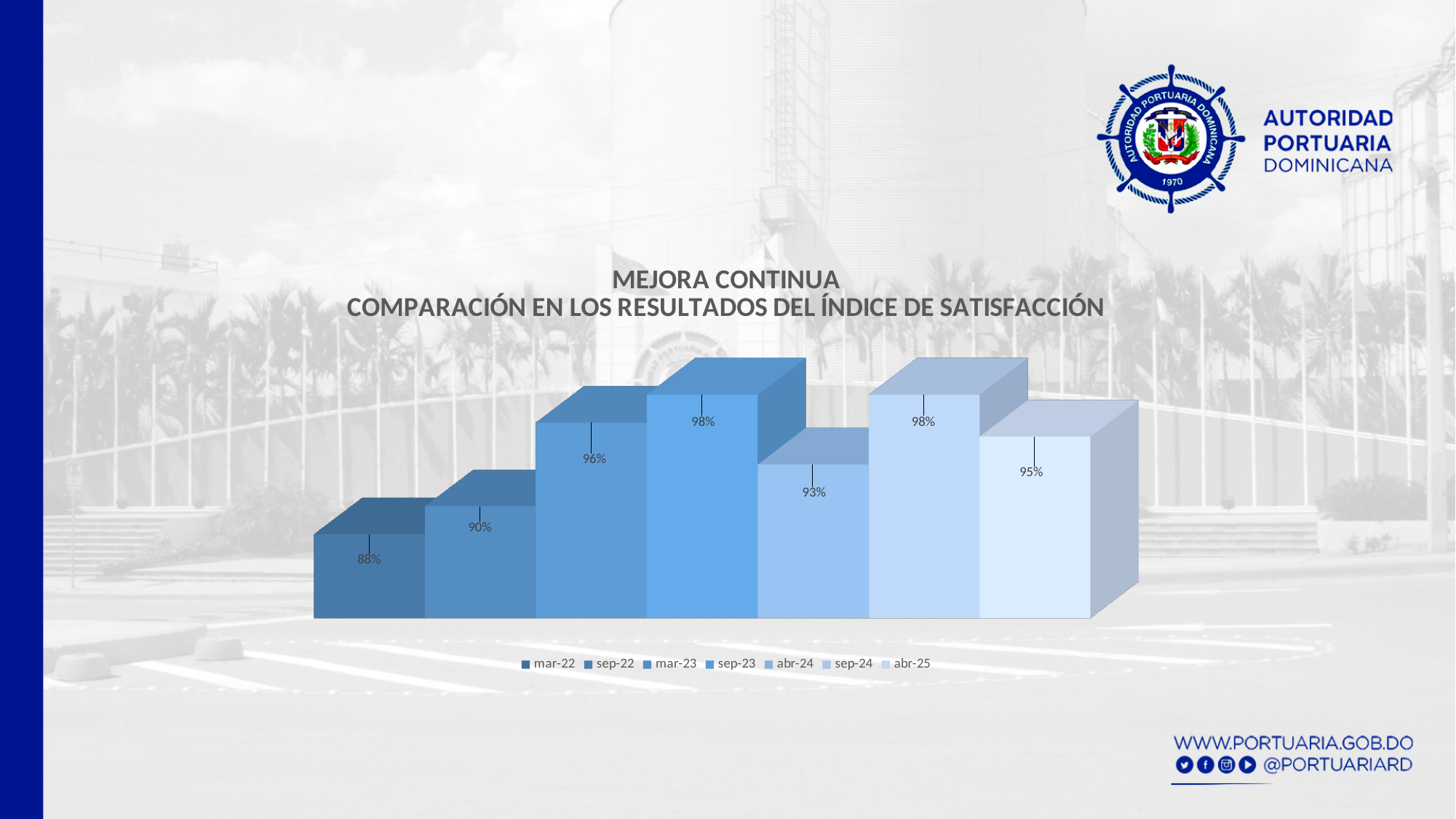
What kind of chart is shown on the slide? Bar chart What is the satisfaction index value for sep-22? 90% How many bars are plotted in the chart? 7 What is the satisfaction index value for mar-22? 88% How many entries does the legend list? 7 What is the satisfaction index value for mar-23? 96% What is the satisfaction index value for abr-25? 95% Which period has the lowest satisfaction index value? mar-22 What is the difference between the values for mar-22 and sep-22? 2% What is the difference between the values for sep-23 and abr-24? 5% What is the satisfaction index value for abr-24? 93% Which is larger, the value for abr-25 or the value for abr-24? abr-25